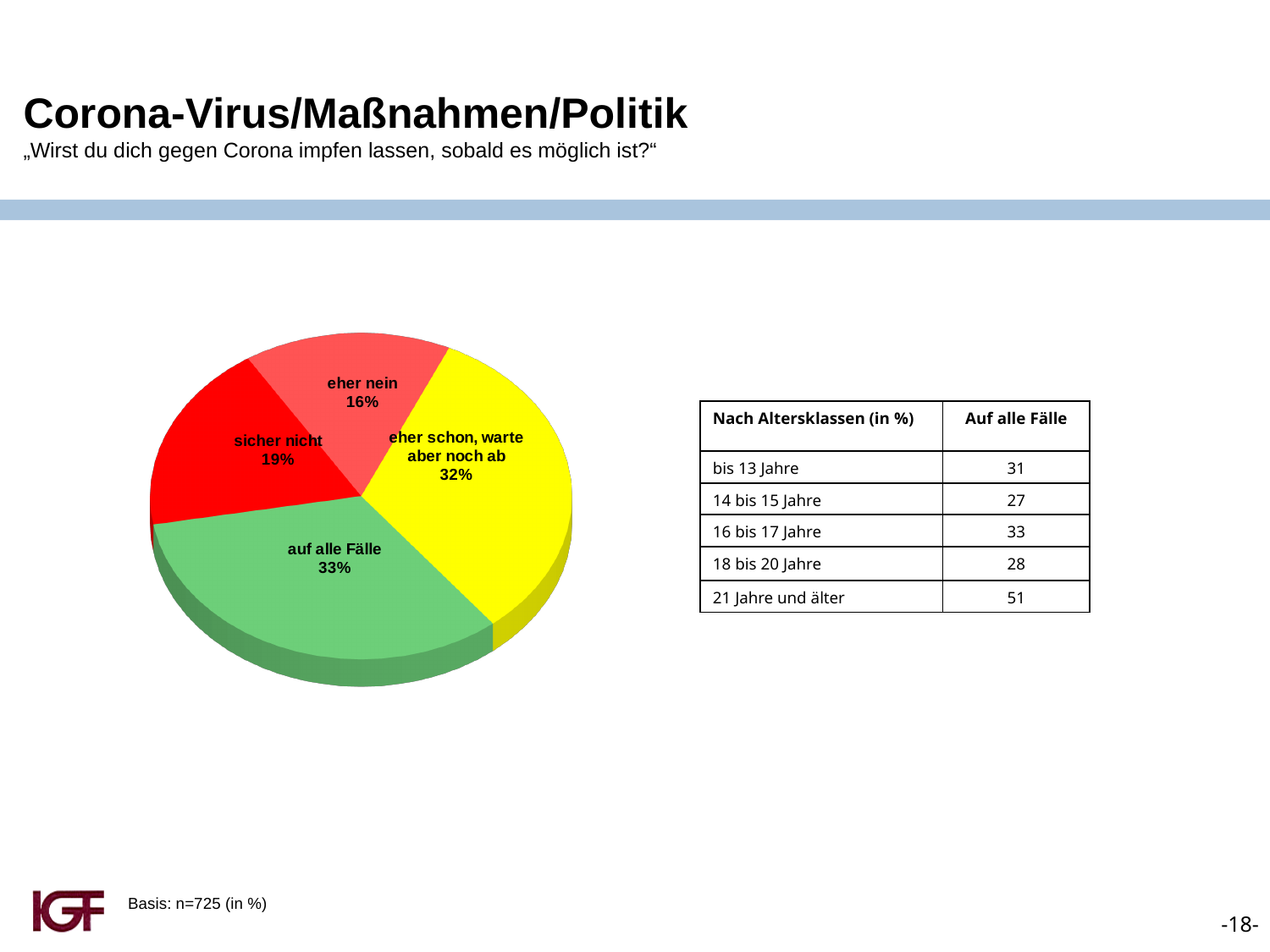
How many slices does the pie chart have? 4 Which slice of the pie chart is the smallest? eher nein What kind of chart is shown on the slide? pie chart What colour is the "auf alle Fälle" slice in the pie chart? green What is the value shown for "eher schon, warte aber noch ab" in the pie chart? 32% What is the difference in percentage points between "sicher nicht" and "eher nein"? 3 Which slice of the pie chart is the largest? auf alle Fälle Which is larger, the slice for "sicher nicht" or the slice for "eher nein"? sicher nicht What share of the pie does "auf alle Fälle" represent? 33% What is the value shown for "sicher nicht" in the pie chart? 19% What is the value shown for "eher nein" in the pie chart? 16% What colour is the "eher schon, warte aber noch ab" slice in the pie chart? yellow